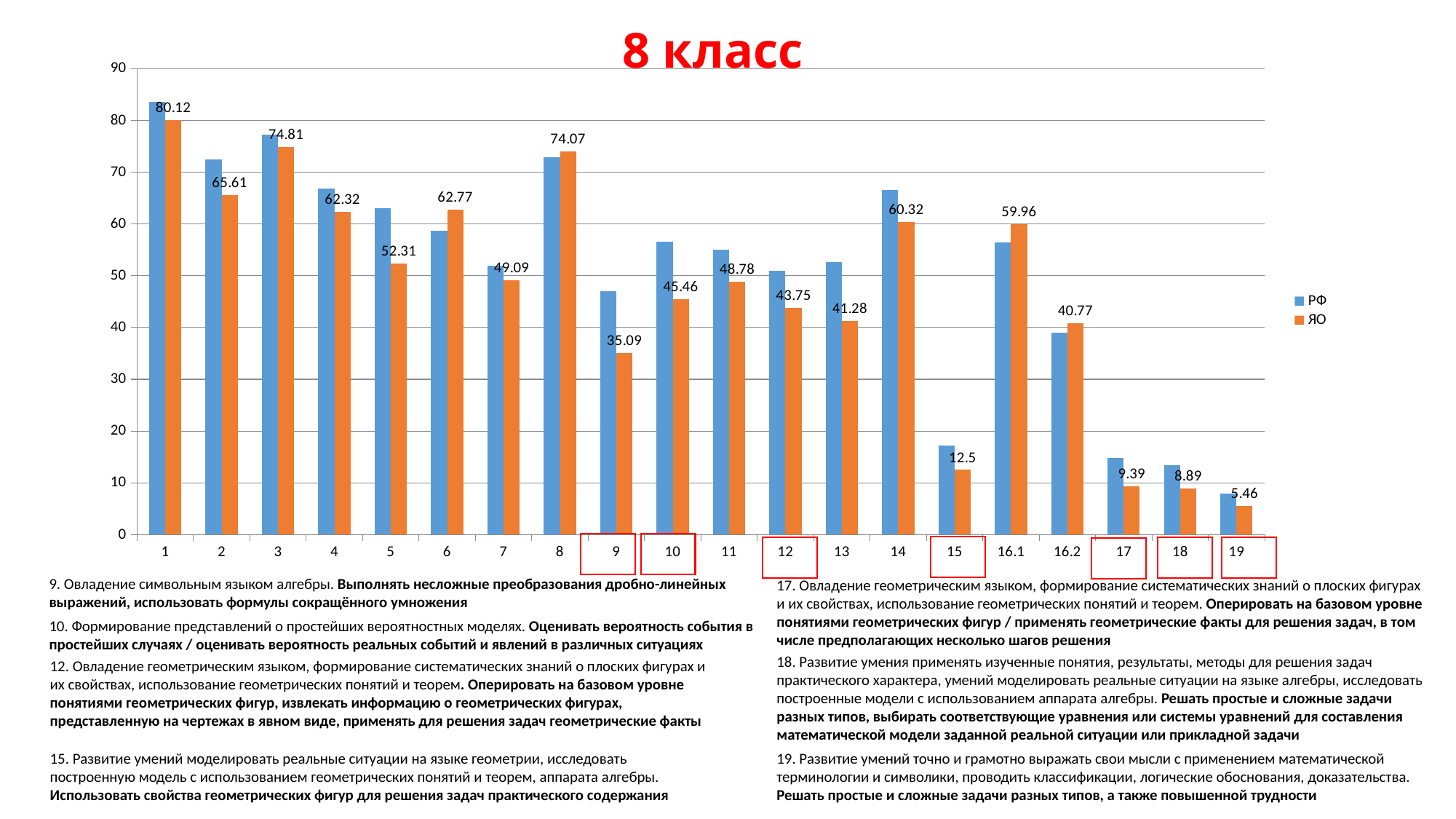
What is the ЯО value for category 1? 80.12 For category 6, which series has the larger value, РФ or ЯО? ЯО Is the РФ value for category 16.2 greater or less than 40? less What is the ЯО value for category 15? 12.5 Is the РФ value for category 1 greater or less than 80? greater What is the difference between the ЯО values for category 1 and category 19? 74.66 What is the ЯО value for category 16.2? 40.77 What type of chart is shown on the slide? bar chart How many categories are shown on the x axis? 20 Which category has the lowest ЯО value? 19 How many series does the legend list? 2 Which category has the highest ЯО value? 1